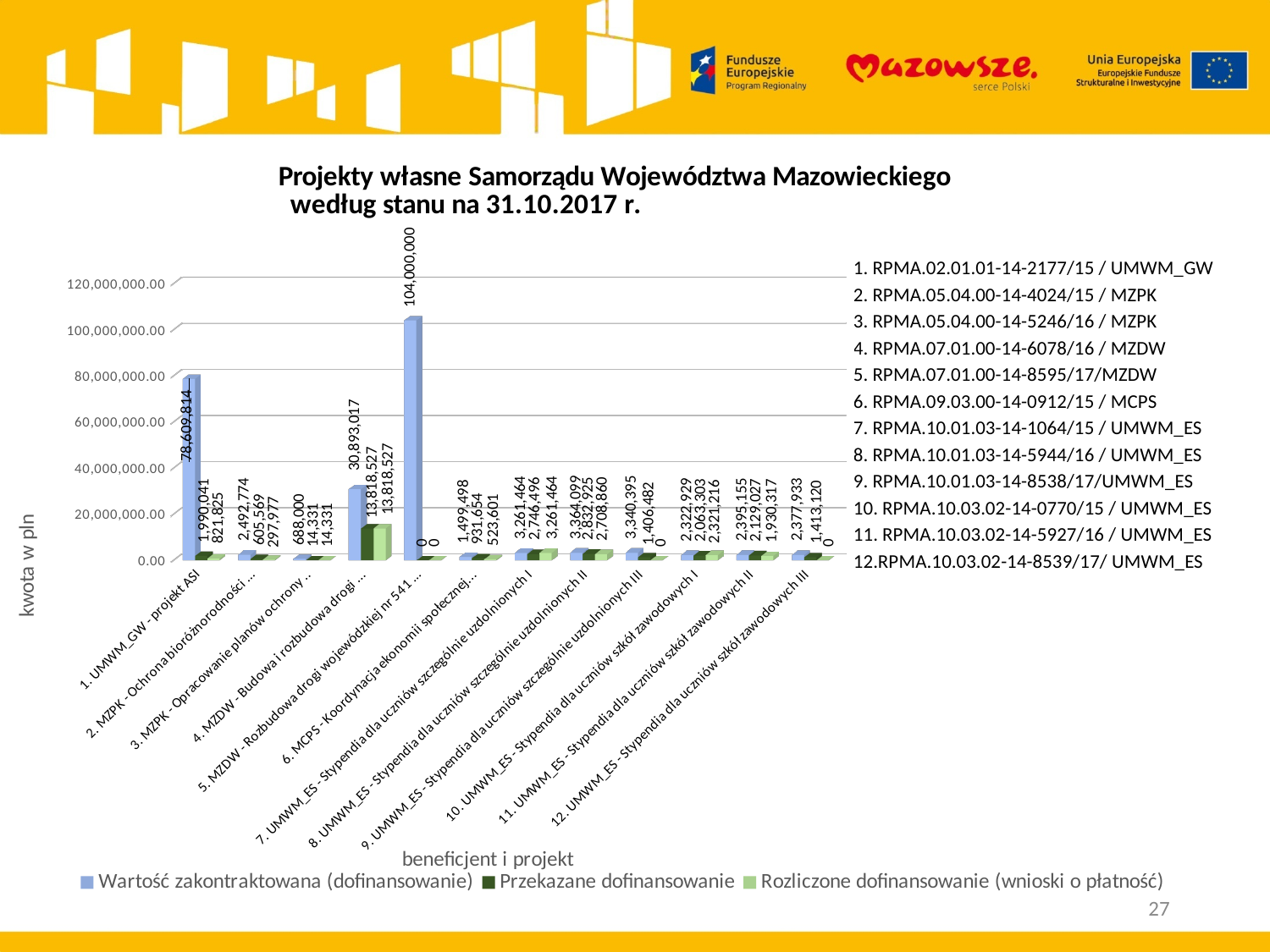
Is the contracted value for project 5, MZDW - Rozbudowa drogi wojewódzkiej nr 541, greater or less than 100,000,000.00? greater Which project has the highest contracted value (Wartość zakontraktowana)? 5. MZDW - Rozbudowa drogi wojewódzkiej nr 541 What is the Przekazane dofinansowanie value for project 4, MZDW - Budowa i rozbudowa drogi? 13,818,527 What is the Rozliczone dofinansowanie value for project 6, MCPS - Koordynacja ekonomii społecznej? 523,601 Which is larger: the contracted value for project 8 (Stypendia dla uczniów szczególnie uzdolnionych II) or for project 11 (Stypendia dla uczniów szkół zawodowych II)? Project 8 (3,364,099) How many projects (categories) are shown on the x axis of the chart? 12 What is the difference between the contracted value and the Przekazane dofinansowanie for project 1, UMWM_GW - projekt ASI? 76,619,773 Which project has the lowest contracted value (Wartość zakontraktowana)? 3. MZPK - Opracowanie planów ochrony How many series does the chart legend list? 3 What is the contracted value (Wartość zakontraktowana) for project 1, UMWM_GW - projekt ASI? 78,609,814 What is the contracted value (Wartość zakontraktowana) for project 5, MZDW - Rozbudowa drogi wojewódzkiej nr 541? 104,000,000 What type of chart is shown on the slide? Bar chart